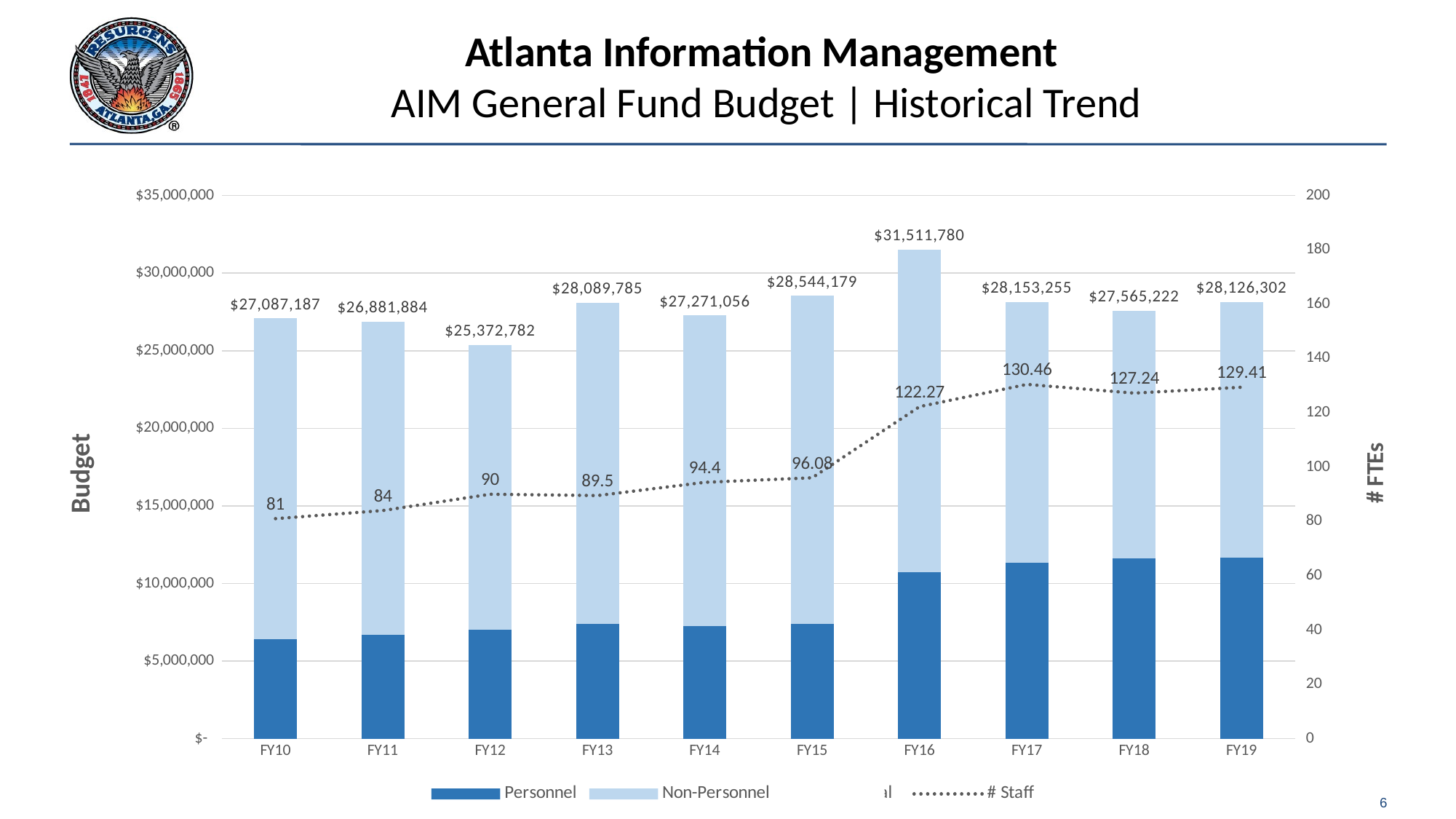
What is the difference between the FY16 total budget and the FY12 total budget? $6,138,998 How many staff (# Staff) are shown for FY17? 130.46 By how much did # Staff increase from FY10 to FY17? 49.46 How many fiscal years are shown on the x axis? 10 What is the # Staff value for FY10? 81 Is the Personnel value for FY10 greater or less than $10,000,000? less Does the # Staff line generally rise or fall from FY10 to FY19? rise What was the total AIM General Fund budget in FY16? $31,511,780 What was the total budget labelled for FY12? $25,372,782 Which fiscal year has the highest total budget? FY16 Which is larger, the total budget for FY13 or for FY14? FY13 Which fiscal year has the lowest total budget? FY12